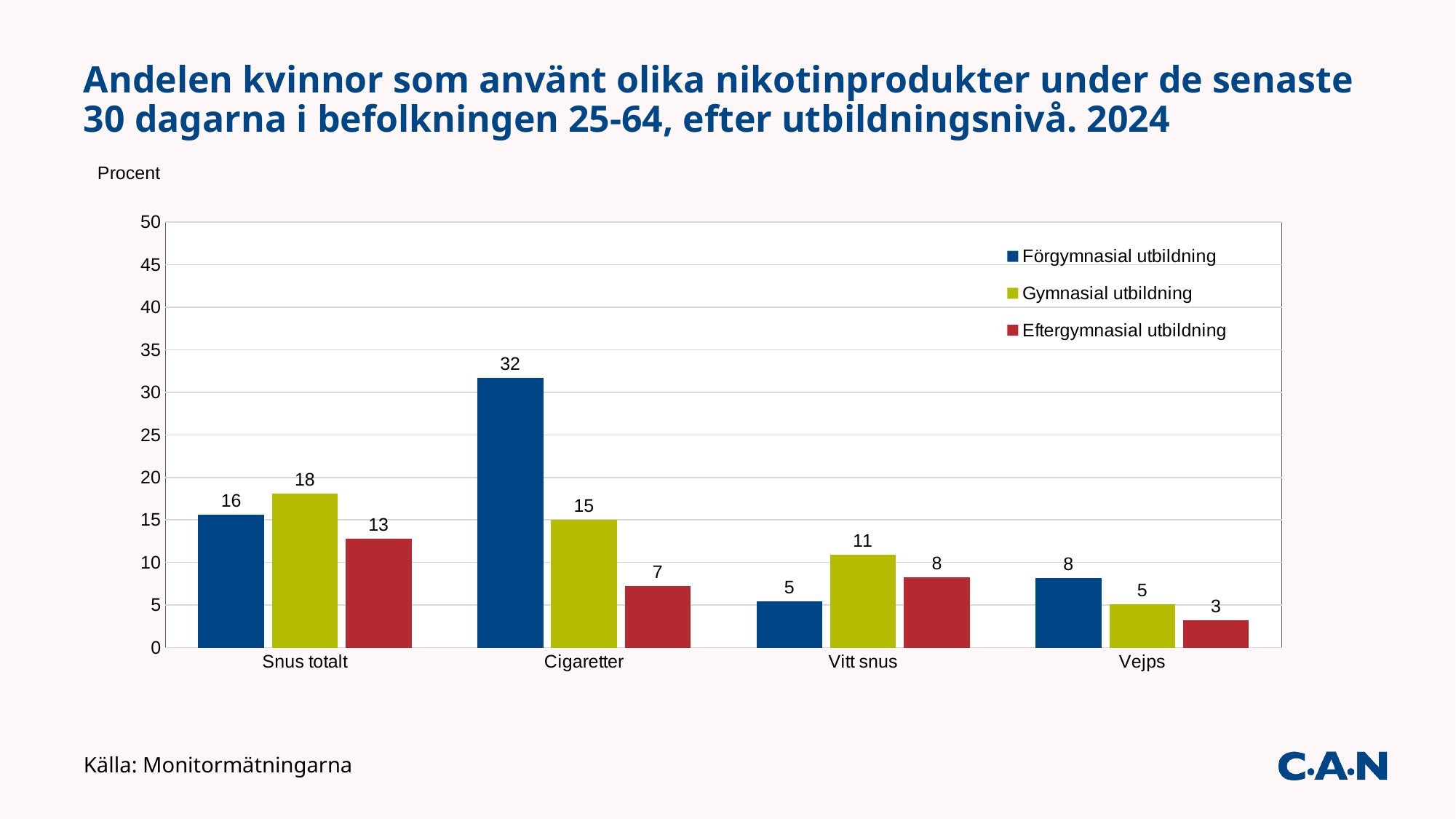
How many categories are shown on the x axis? 4 Which category has the lowest value for Gymnasial utbildning? Vejps What is the value for Förgymnasial utbildning in the Cigaretter category? 32 What kind of chart is shown on the slide? Bar chart What is the value for Gymnasial utbildning in the Snus totalt category? 18 What source is cited at the bottom of the slide? Monitormätningarna What is the label on the vertical axis? Procent In the Vitt snus category, which is larger: Gymnasial utbildning or Förgymnasial utbildning? Gymnasial utbildning What is the difference between Förgymnasial utbildning and Eftergymnasial utbildning in the Cigaretter category? 25 Which category has the highest value for Förgymnasial utbildning? Cigaretter What is the value for Eftergymnasial utbildning in the Vejps category? 3 How many series does the legend list? 3